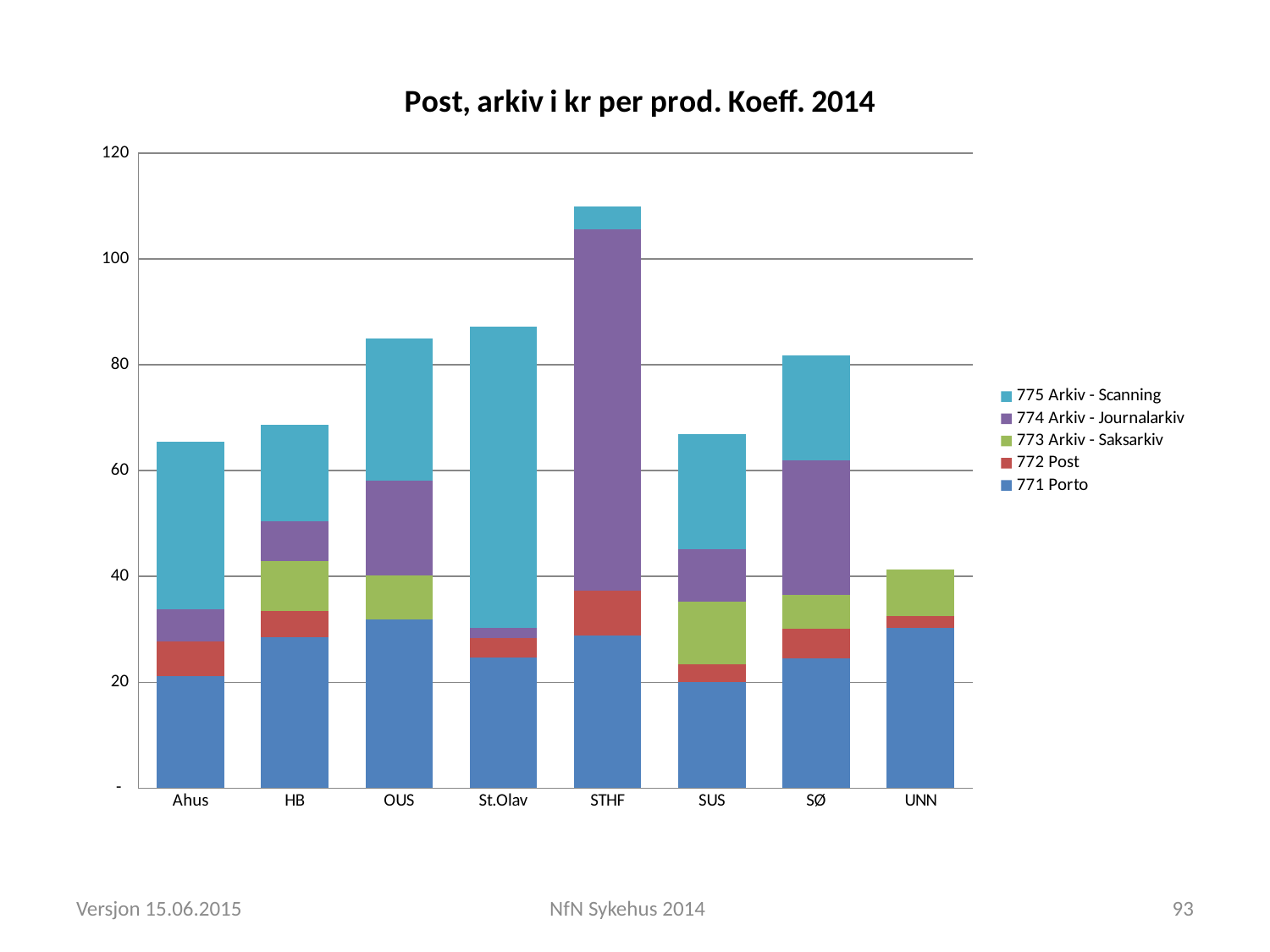
Is the total for STHF greater or less than 100? greater What is the title of the chart? Post, arkiv i kr per prod. Koeff. 2014 Which series forms the largest segment of the STHF bar? 774 Arkiv - Journalarkiv Is the total for UNN greater or less than 60? less Which has the larger total, STHF or SØ? STHF Which category has the lowest total stacked bar? UNN Is the total for OUS greater or less than 80? greater Which category has the largest 775 Arkiv - Scanning segment? St.Olav What kind of chart is shown on the slide? Stacked bar chart How many series does the legend list? 5 How many categories are shown on the x axis? 8 Which category has the highest total stacked bar? STHF